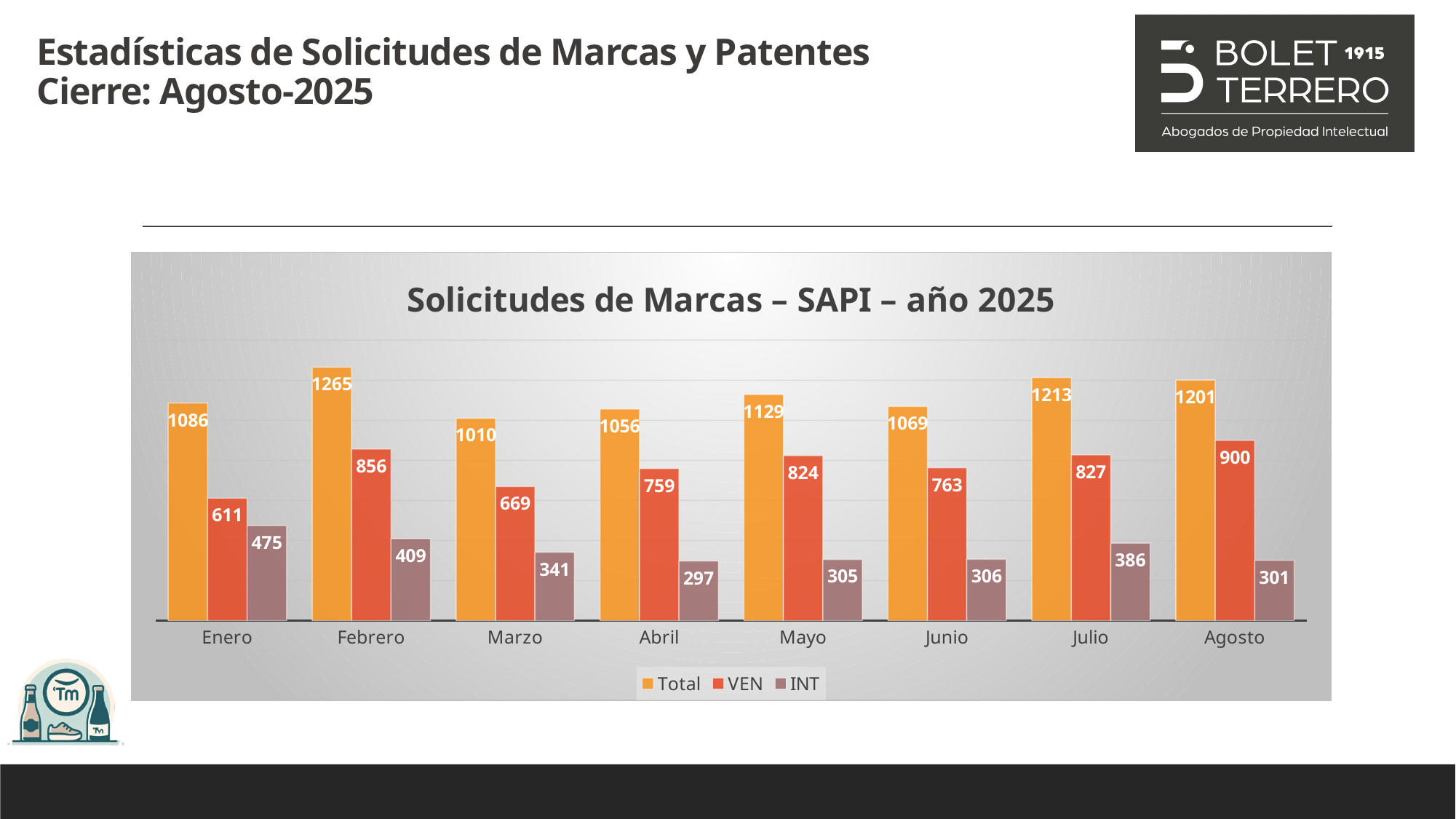
What is the title of the chart? Solicitudes de Marcas – SAPI – año 2025 Which month has the highest INT value? Enero How many months are shown on the x axis? 8 How many series does the legend list? 3 Which month has the highest Total value? Febrero What kind of chart is shown? Bar chart What is the VEN value for Agosto? 900 Which is larger, the VEN value for Mayo or the VEN value for Julio? Julio What is the Total value for Febrero? 1265 Which month has the lowest Total value? Marzo What is the INT value for Abril? 297 What is the difference between the Total values for Febrero and Marzo? 255